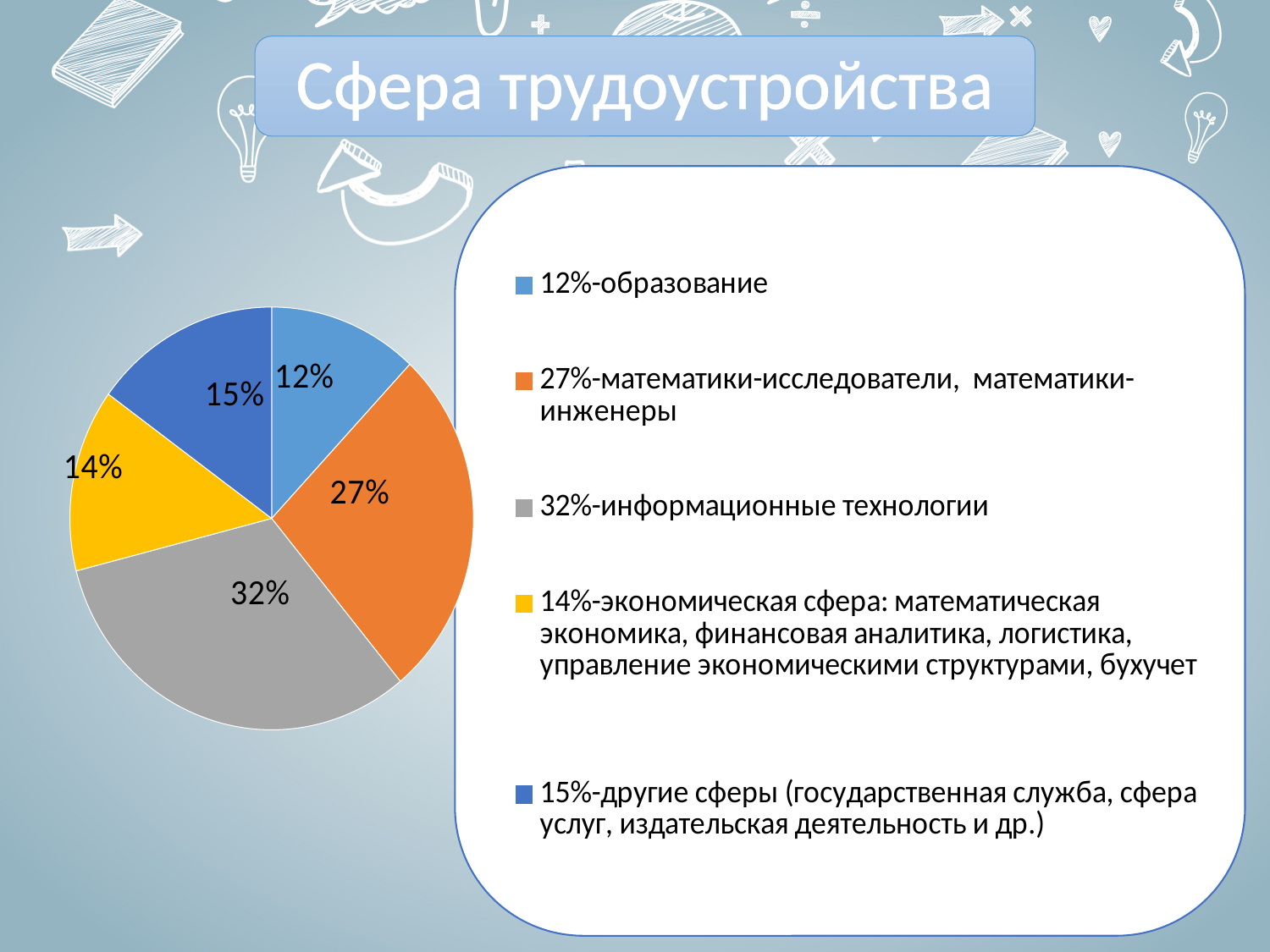
What is the share for другие сферы? 15% What is the share for информационные технологии? 32% What is the difference between the shares for информационные технологии and образование? 20% What is the share for математики-исследователи, математики-инженеры? 27% What is the share for образование? 12% Which category has the smallest slice of the pie? образование Which category has the largest slice of the pie? информационные технологии What type of chart is shown on the slide? pie chart Which is larger, the share for другие сферы or the share for экономическая сфера? другие сферы How many slices does the pie chart have? 5 What is the share for экономическая сфера? 14% What is the title of the slide containing the chart? Сфера трудоустройства